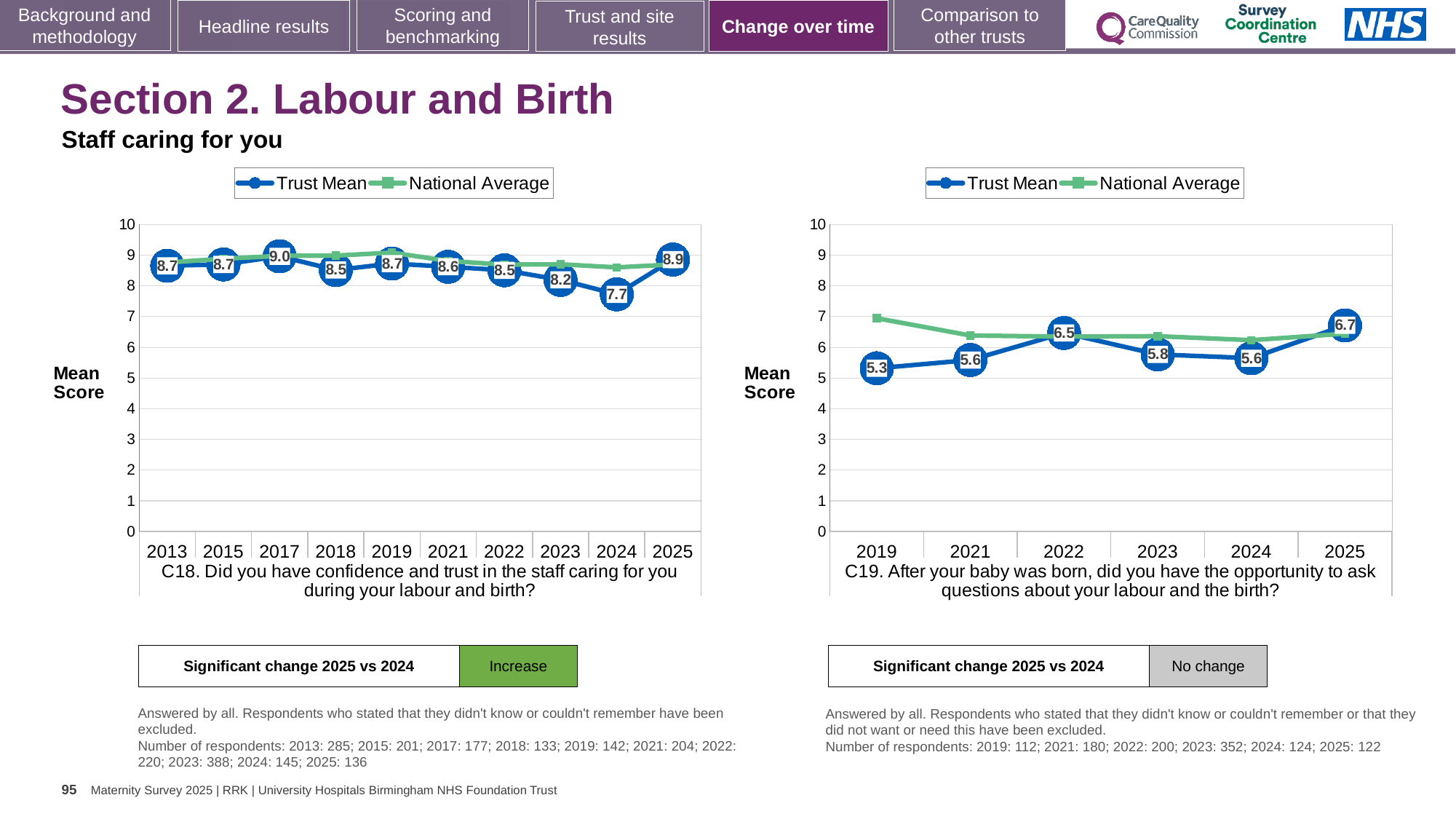
In the C19 chart on the right, what is the Trust Mean for 2019? 5.3 In the C18 chart on the left, which year has the lowest Trust Mean? 2024 In the C19 chart on the right, is the Trust Mean for 2022 or for 2023 larger? 2022 In the C19 chart on the right, which year has the highest Trust Mean? 2025 What kind of chart is the C18 chart on the left? Line chart How many series does the legend of the C19 chart on the right list? 2 In the C18 chart on the left, what is the Trust Mean for 2024? 7.7 In the C18 chart on the left, how many years are shown on the x axis? 10 In the C18 chart on the left, what is the difference between the Trust Mean for 2025 and for 2024? 1.2 In the C18 chart on the left, what is the Trust Mean for 2025? 8.9 In the C19 chart on the right, is the National Average for 2019 greater or less than 6? greater In the C18 chart on the left, which year has the highest Trust Mean? 2017